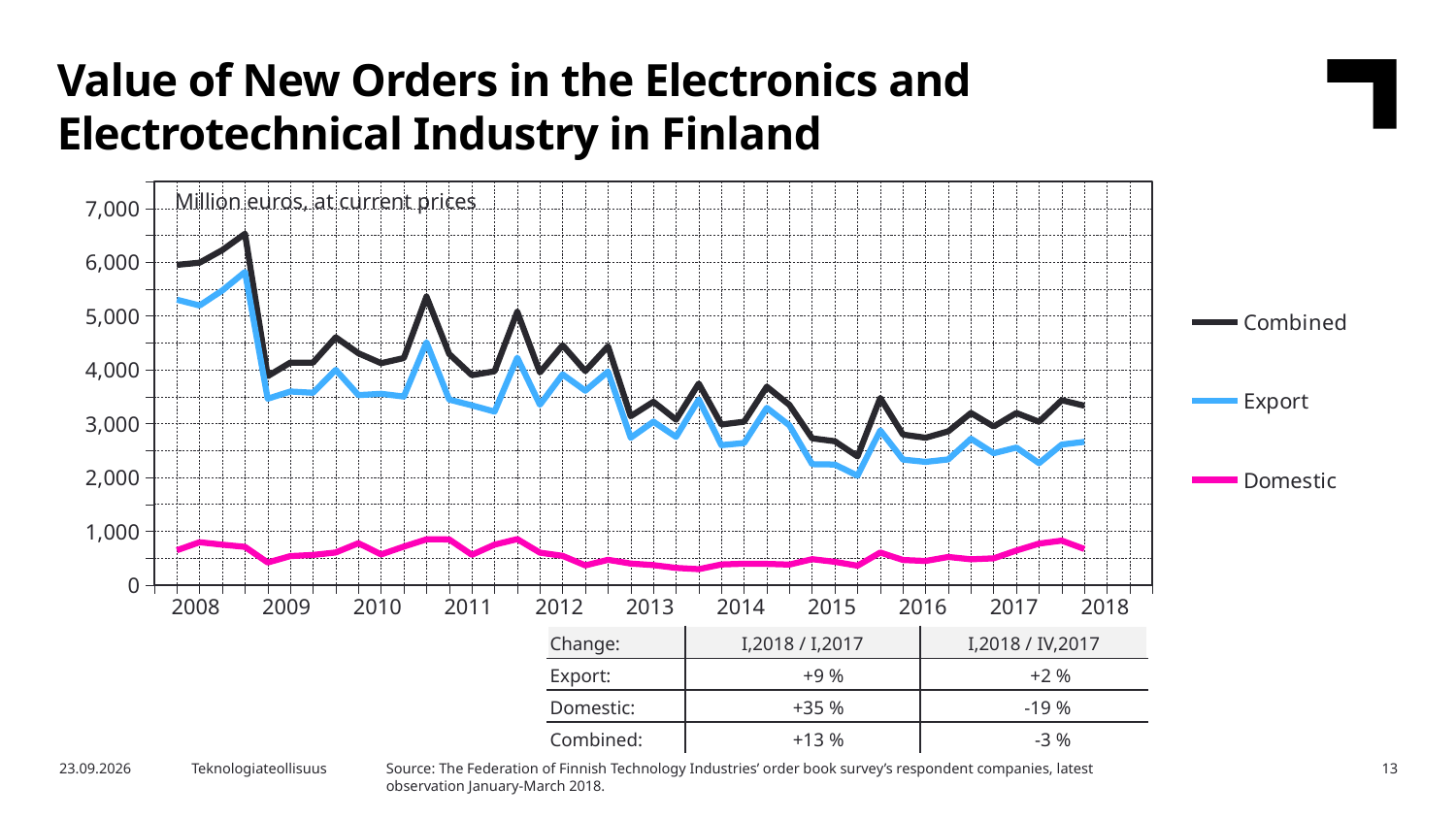
Is the Domestic value at the start of 2008 greater or less than 1,000? less What unit label is printed inside the chart area? Million euros, at current prices How many year labels are shown on the x axis? 11 Which series has the lowest values throughout the chart? Domestic Is the Export value at the end of the series in 2018 greater or less than 3,000? less What are the three series named in the chart's legend? Combined, Export, Domestic Is the Export value at the start of 2008 greater or less than 5,000? greater Overall, does the Combined series rise or fall from 2008 to 2018? fall What kind of chart is shown on the slide? line chart How many series does the chart's legend list? 3